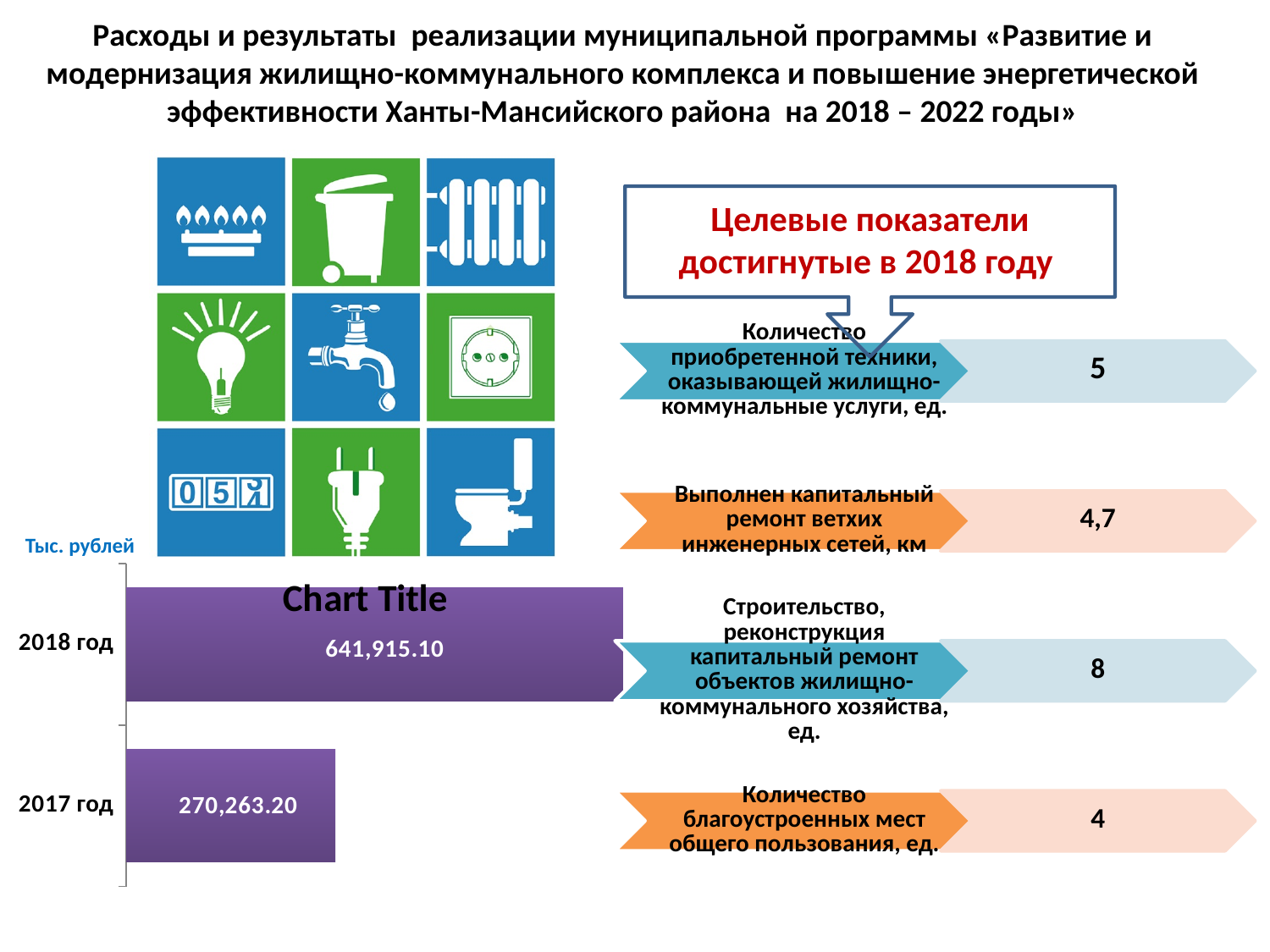
How many categories (years) are shown in the bar chart? 2 What unit label is shown above the bar chart? Тыс. рублей Do the values in the bar chart rise or fall from 2017 год to 2018 год? rise What is the difference between the values for 2018 год and 2017 год in the bar chart? 371,651.90 Which year has the lowest value in the bar chart? 2017 год What is the value for 2018 год in the bar chart? 641,915.10 Which is larger in the bar chart: the value for 2018 год or the value for 2017 год? 2018 год Which year has the highest value in the bar chart? 2018 год What type of chart is shown on the slide? bar chart What is the value for 2017 год in the bar chart? 270,263.20 What is the title shown on the bar chart? Chart Title